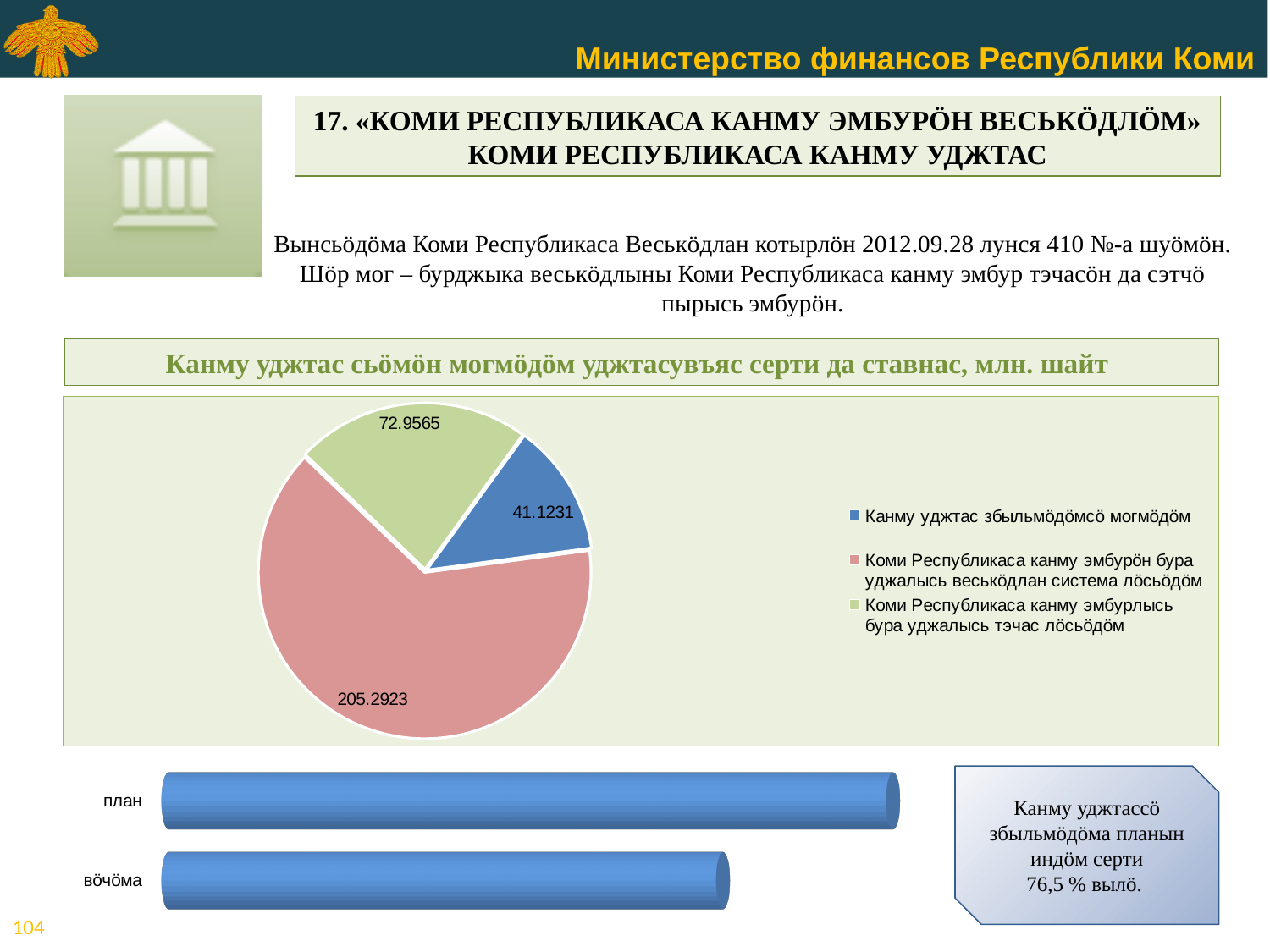
In the pie chart, what is the value for «Коми Республикаса канму эмбурӧн бура уджалысь веськӧдлан система лӧсьӧдӧм»? 205.2923 What kind of chart is the chart at the bottom of the slide with the categories «план» and «вӧчӧма»? bar chart In the pie chart, which category has the largest value? Коми Республикаса канму эмбурӧн бура уджалысь веськӧдлан система лӧсьӧдӧм In the pie chart, what is the value for «Канму уджтас збыльмӧдӧмсӧ могмӧдӧм»? 41.1231 In the pie chart, what colour is the slice for «Канму уджтас збыльмӧдӧмсӧ могмӧдӧм»? blue In the bar chart at the bottom of the slide, which bar is longer: «план» or «вӧчӧма»? план In the pie chart, which is larger: the value for «Коми Республикаса канму эмбурлысь бура уджалысь тэчас лӧсьӧдӧм» or the value for «Канму уджтас збыльмӧдӧмсӧ могмӧдӧм»? Коми Республикаса канму эмбурлысь бура уджалысь тэчас лӧсьӧдӧм In the pie chart, how many slices are there? 3 In the pie chart, what is the value for «Коми Республикаса канму эмбурлысь бура уджалысь тэчас лӧсьӧдӧм»? 72.9565 In the pie chart, what is the difference between the value 205.2923 and the value 72.9565? 132.3358 In the pie chart, which category has the smallest value? Канму уджтас збыльмӧдӧмсӧ могмӧдӧм What kind of chart is the chart titled «Канму уджтас сьӧмӧн могмӧдӧм уджтасувъяс серти да ставнас, млн. шайт»? pie chart